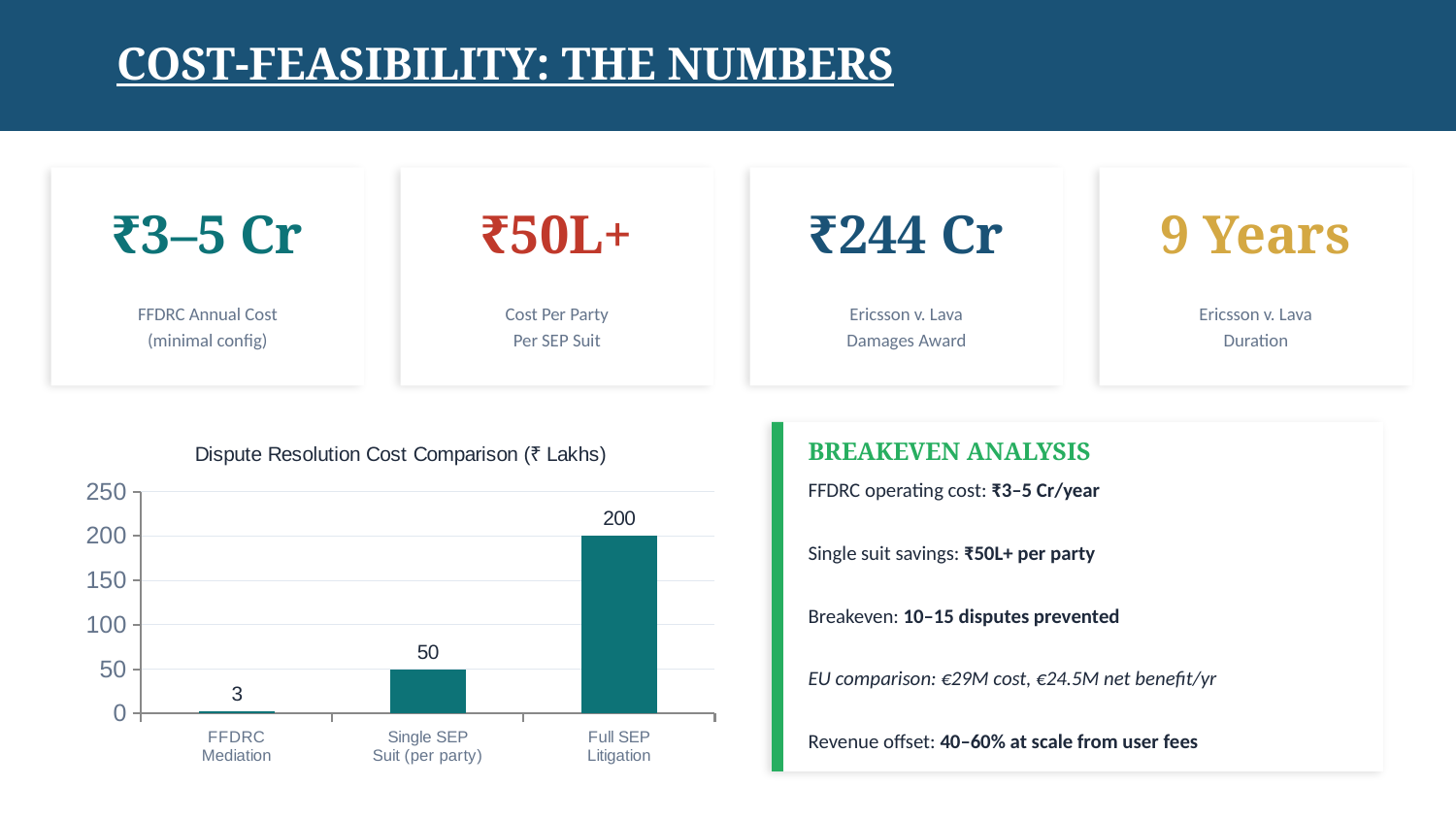
Is the value for Full SEP Litigation greater or less than 150? greater What is the value for Single SEP Suit (per party) in the chart? 50 What is the value for FFDRC Mediation in the Dispute Resolution Cost Comparison chart? 3 What kind of chart is shown on the slide? Bar chart Which category has the lowest value in the chart? FFDRC Mediation What is the value for Full SEP Litigation in the chart? 200 What is the title of the chart on the slide? Dispute Resolution Cost Comparison (₹ Lakhs) How many categories are shown in the chart? 3 What is the difference between the values for Full SEP Litigation and Single SEP Suit (per party)? 150 Which is larger: the value for Single SEP Suit (per party) or FFDRC Mediation? Single SEP Suit (per party) Which category has the highest value in the chart? Full SEP Litigation What is the difference between the values for Single SEP Suit (per party) and FFDRC Mediation? 47